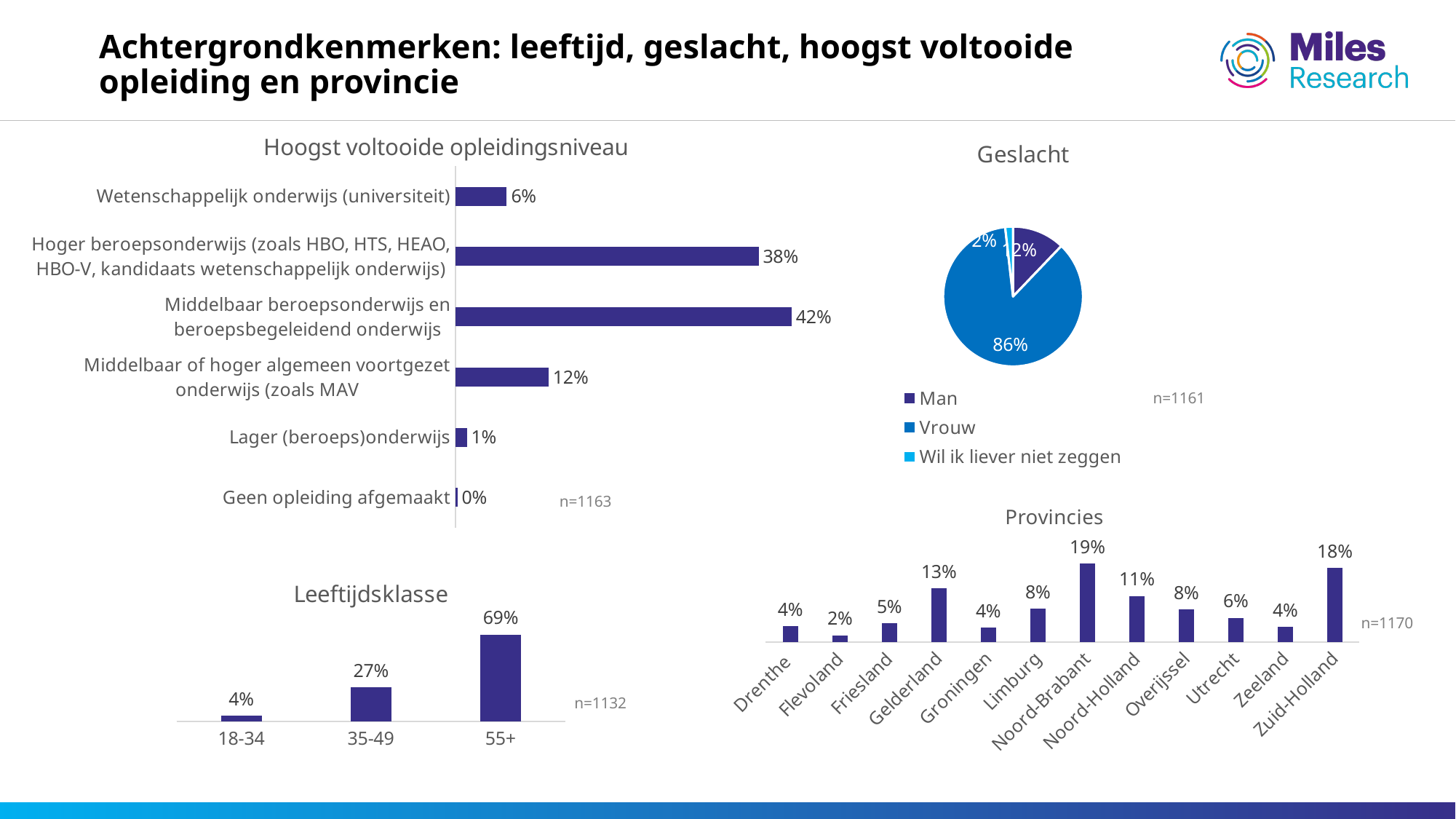
How many categories does the 'Hoogst voltooide opleidingsniveau' chart show? 6 In the 'Geslacht' pie chart, what share is 'Vrouw'? 86% How many entries does the legend of the 'Geslacht' chart list? 3 In the 'Leeftijdsklasse' chart, do the values rise or fall from '18-34' to '55+'? Rise In the 'Provincies' chart, which is larger: Gelderland or Noord-Holland? Gelderland In the 'Hoogst voltooide opleidingsniveau' chart, what is the difference between 'Middelbaar beroepsonderwijs en beroepsbegeleidend onderwijs' and 'Wetenschappelijk onderwijs (universiteit)'? 36% What kind of chart is the 'Geslacht' chart? Pie chart In the 'Provincies' chart, what is the value for Zuid-Holland? 18% In the 'Hoogst voltooide opleidingsniveau' chart, which category has the highest value? Middelbaar beroepsonderwijs en beroepsbegeleidend onderwijs In the 'Provincies' chart, which province has the highest value? Noord-Brabant In the 'Leeftijdsklasse' chart, what is the value for '35-49'? 27% In the 'Hoogst voltooide opleidingsniveau' chart, what is the value for 'Hoger beroepsonderwijs (zoals HBO, HTS, HEAO, HBO-V, kandidaats wetenschappelijk onderwijs)'? 38%